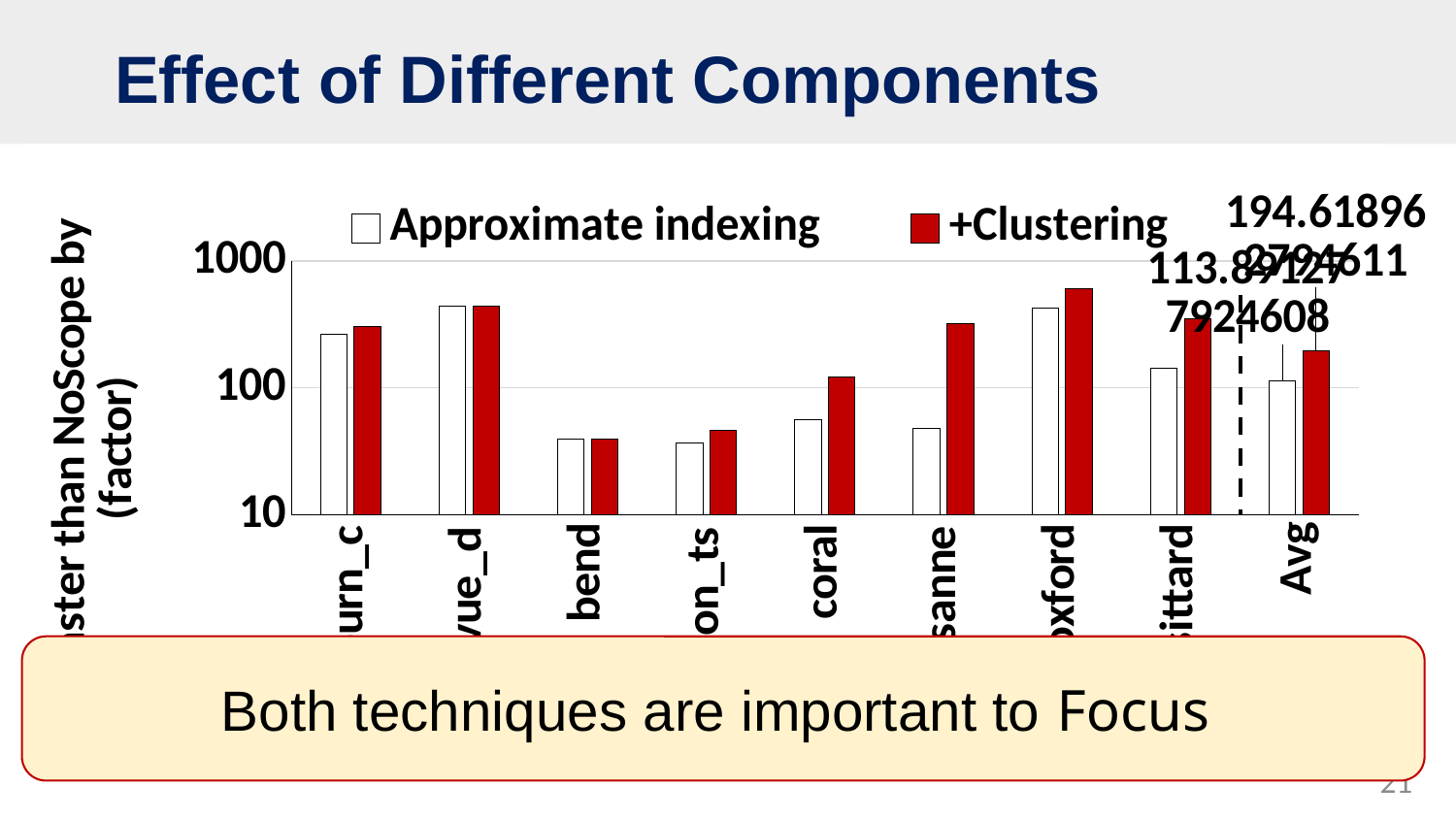
Is the +Clustering value for oxford greater or less than 1000? less Which colour represents the +Clustering series in the chart? red Is the +Clustering value for Avg greater or less than 100? greater For sanne, which series has the larger value: Approximate indexing or +Clustering? +Clustering What kind of chart is shown on the slide? bar chart What are the two series named in the legend? Approximate indexing and +Clustering Is the +Clustering value for bend greater or less than 100? less For coral, which series has the larger value: Approximate indexing or +Clustering? +Clustering How many series does the chart's legend list? 2 Which category has the highest +Clustering value? oxford How many categories are shown along the x axis of the chart? 9